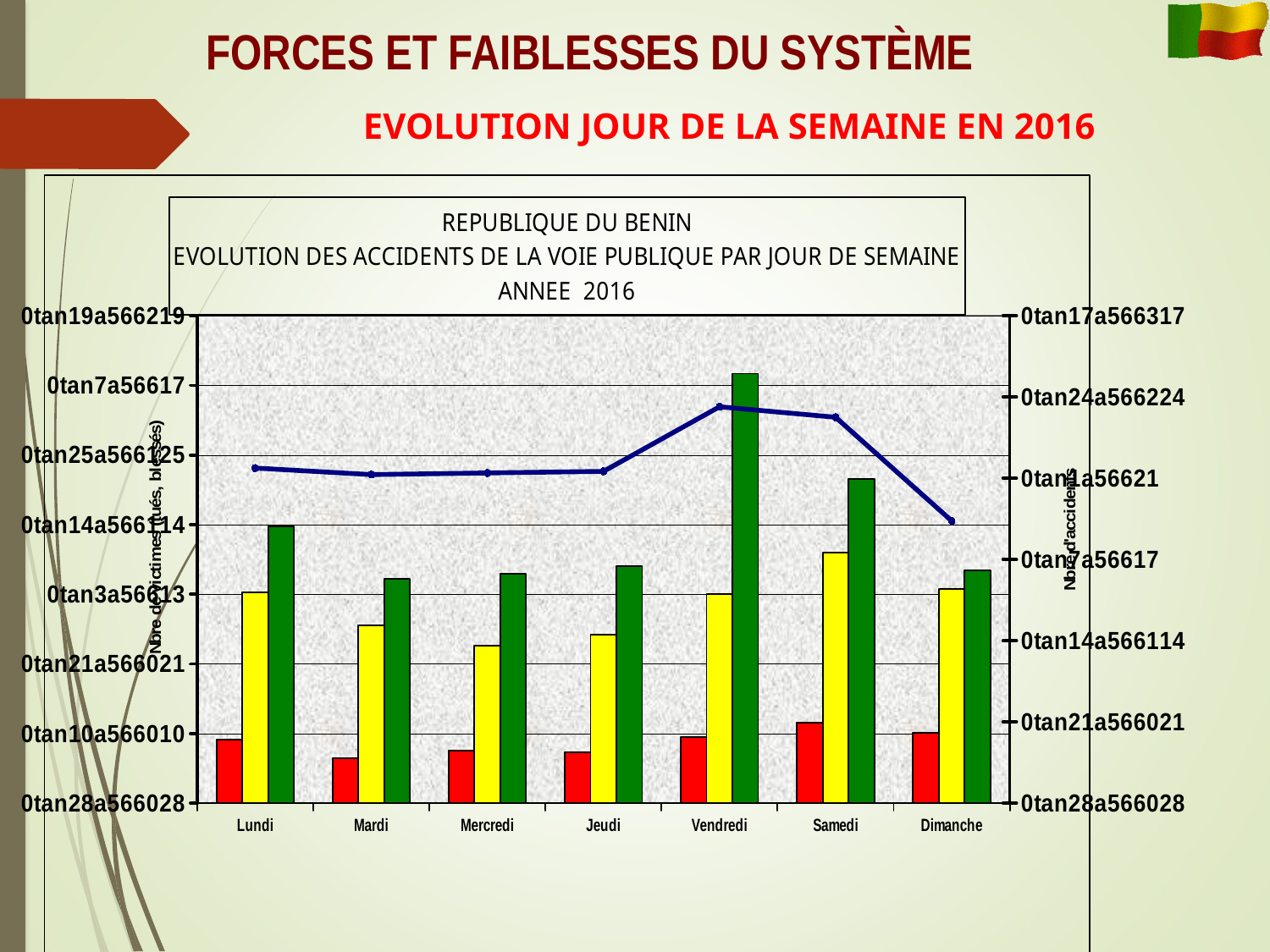
Which day has the tallest green bar in the chart? Vendredi How many days of the week are shown on the x axis of the chart? 7 Is the yellow bar taller for Samedi or for Mercredi? Samedi Which year does the chart title say the data is for? 2016 On which day does the blue line reach its lowest point? Dimanche Which day has the tallest red bar in the chart? Samedi Which day has the tallest yellow bar in the chart? Samedi Is the green bar taller for Vendredi or for Lundi? Vendredi Which day has the shortest red bar in the chart? Mardi Does the blue line rise or fall from Vendredi to Dimanche? Fall What kind of chart is shown on the slide? Combined bar and line chart